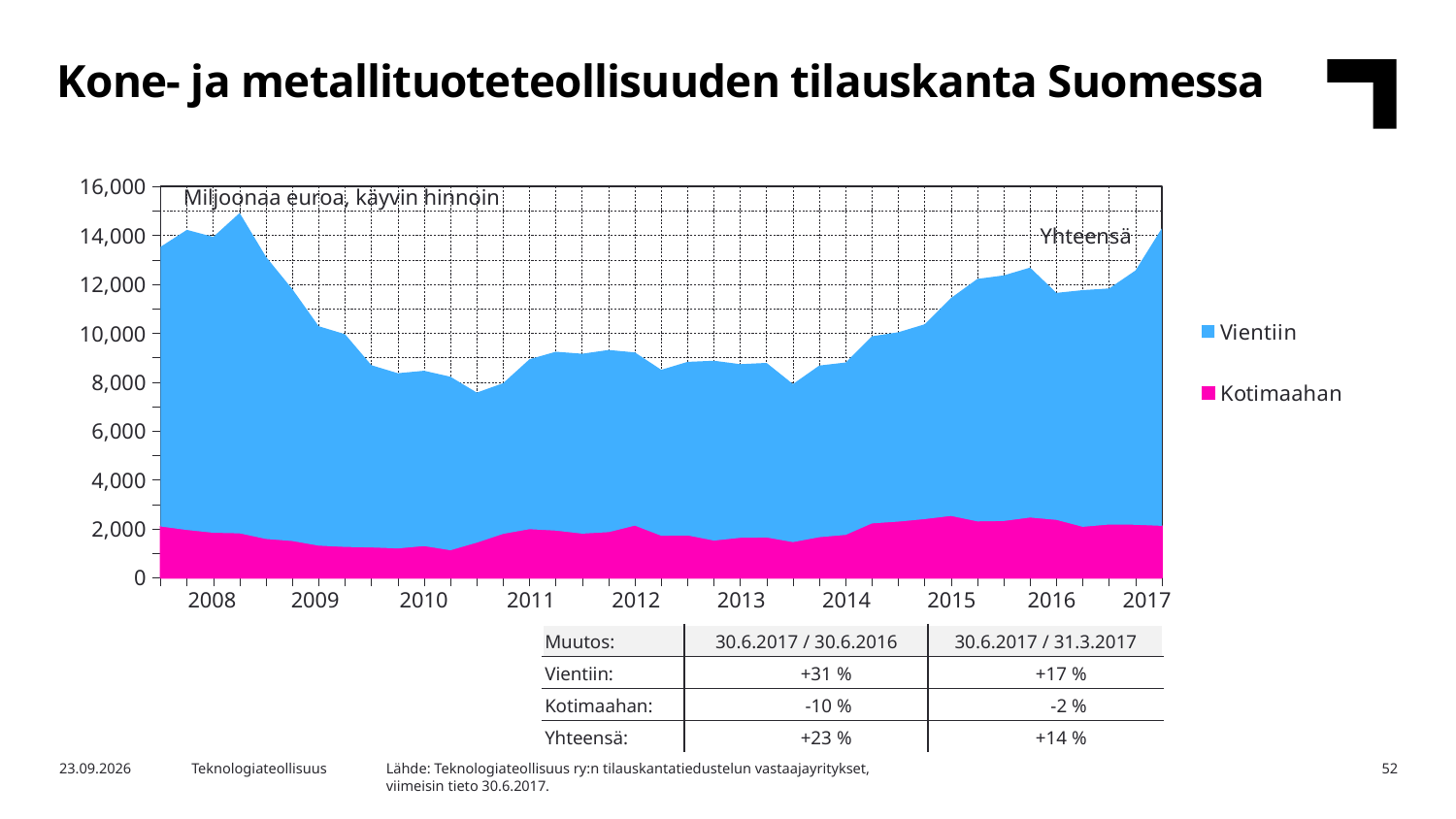
What are the two series named in the chart legend? Vientiin and Kotimaahan What unit is stated in the chart for the values? Miljoonaa euroa, käyvin hinnoin How many series does the chart legend list? 2 Which series is larger throughout the chart, Vientiin or Kotimaahan? Vientiin How many year labels are shown on the x axis? 10 In which year does the total (Yhteensä) reach its highest point on the chart? 2008 Does the total (Yhteensä) rise or fall between 2014 and 2016? rise Is the total (Yhteensä) value at the end of 2017 greater or less than 12,000? greater Is the Kotimaahan value in 2010 greater or less than 2,000? less Is the total (Yhteensä) value in 2012 greater or less than 10,000? less What kind of chart is shown on the slide? Stacked area chart